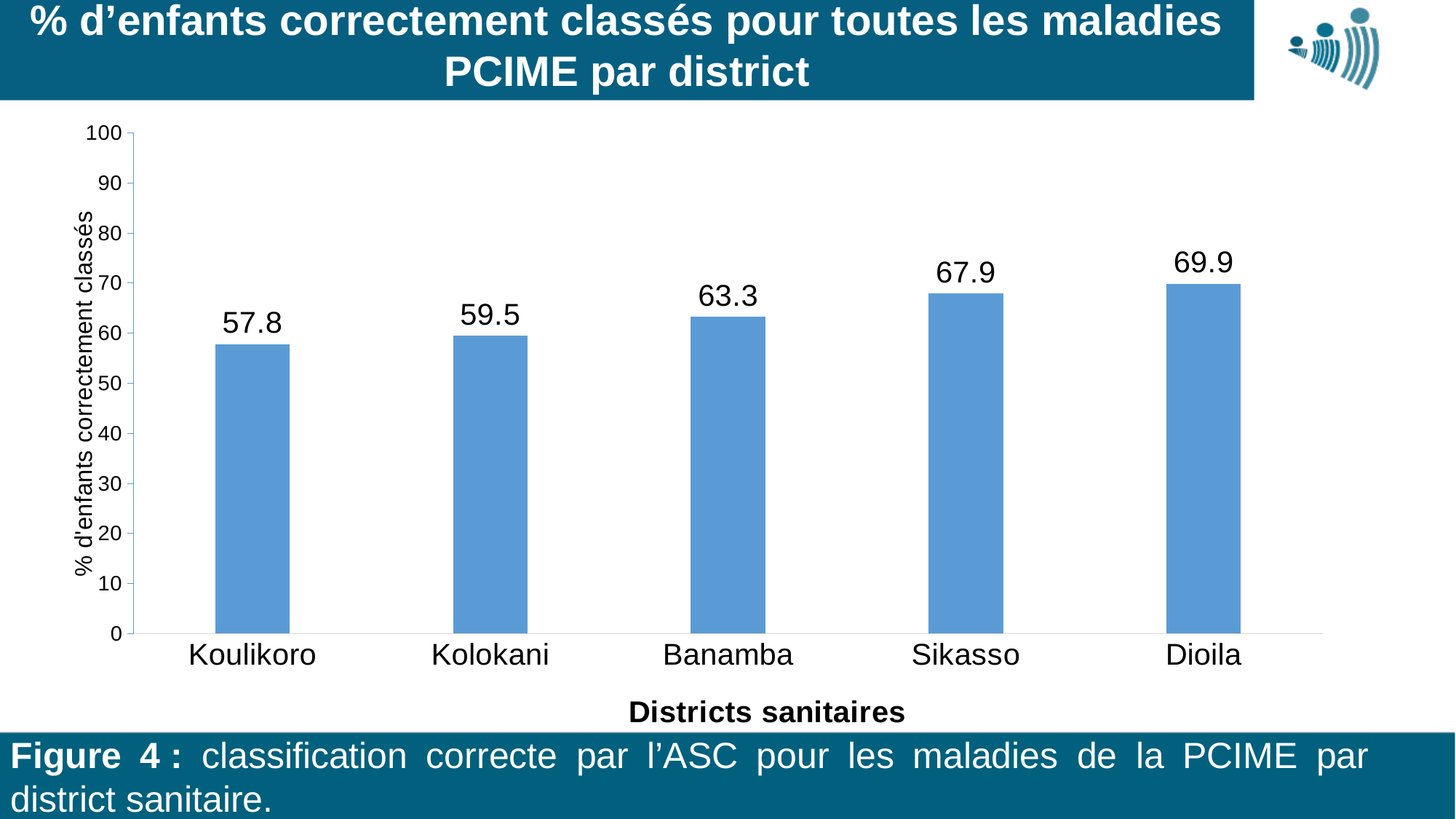
Which district has the lowest value? Koulikoro What is the value for Koulikoro? 57.8 What is the value for Banamba? 63.3 What kind of chart is shown on the slide? bar chart Which district has the highest value? Dioila Do the values rise or fall from Koulikoro to Dioila along the x axis? rise What is the x-axis title of the chart? Districts sanitaires Is the value for Sikasso greater or less than 60? greater What is the value for Dioila? 69.9 What is the difference between the values for Sikasso and Koulikoro? 10.1 Which is larger, the value for Kolokani or the value for Banamba? Banamba How many districts are shown on the x axis? 5